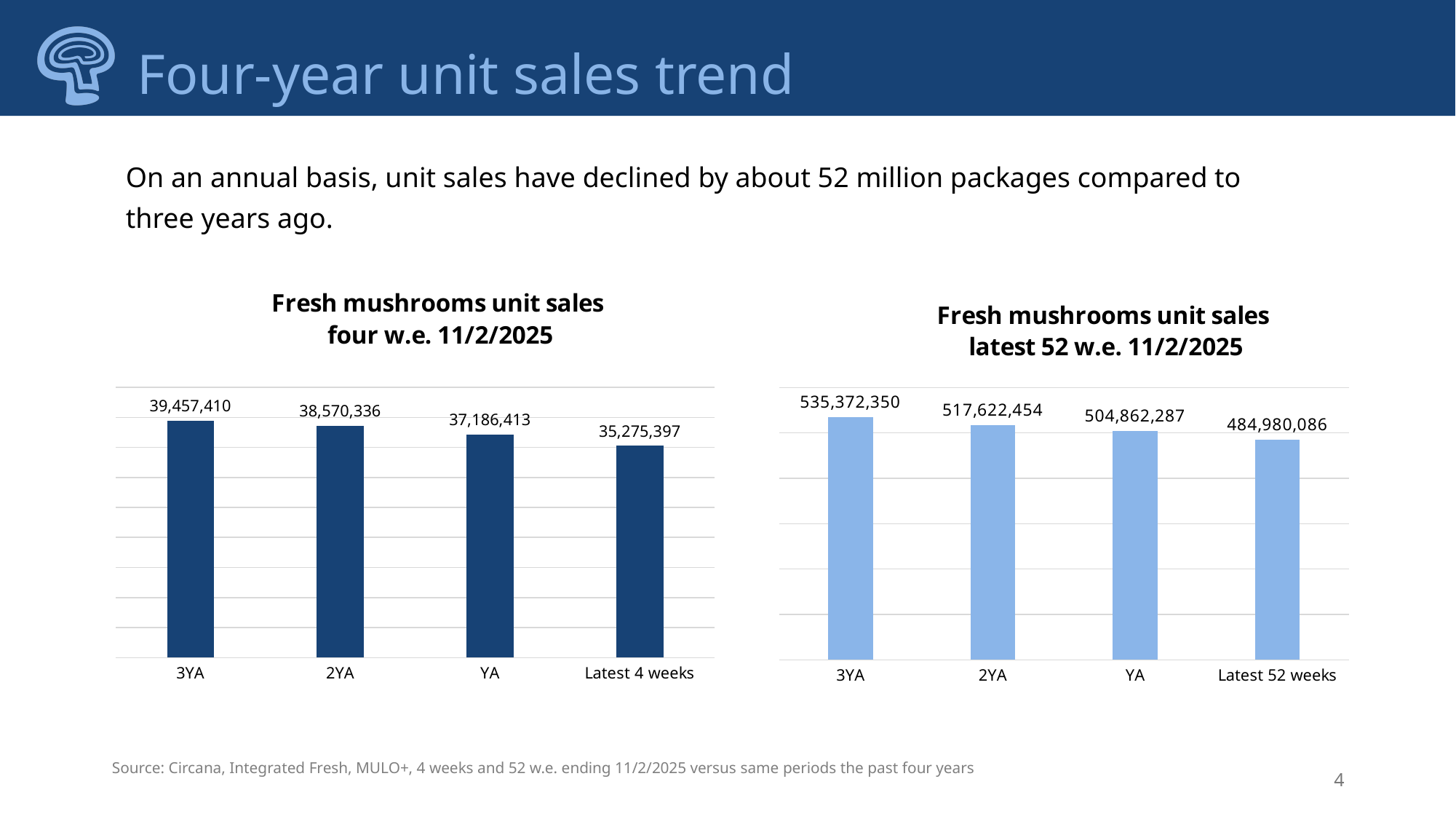
In the 'Fresh mushrooms unit sales four w.e. 11/2/2025' chart, which category has the highest value? 3YA In the 'Fresh mushrooms unit sales latest 52 w.e. 11/2/2025' chart, which category has the lowest value? Latest 52 weeks What kind of chart is the 'Fresh mushrooms unit sales latest 52 w.e. 11/2/2025' chart? Bar chart In the 'Fresh mushrooms unit sales latest 52 w.e. 11/2/2025' chart, what is the difference between the 3YA value and the Latest 52 weeks value? 50,392,264 In the 'Fresh mushrooms unit sales four w.e. 11/2/2025' chart, what is the value for Latest 4 weeks? 35,275,397 In the 'Fresh mushrooms unit sales latest 52 w.e. 11/2/2025' chart, what is the value for Latest 52 weeks? 484,980,086 In the 'Fresh mushrooms unit sales four w.e. 11/2/2025' chart, do the values rise or fall from 3YA to Latest 4 weeks? Fall In the 'Fresh mushrooms unit sales four w.e. 11/2/2025' chart, what is the value for 3YA? 39,457,410 How many categories are shown in the 'Fresh mushrooms unit sales four w.e. 11/2/2025' chart? 4 In the 'Fresh mushrooms unit sales four w.e. 11/2/2025' chart, what is the difference between the 3YA value and the Latest 4 weeks value? 4,182,013 In the 'Fresh mushrooms unit sales latest 52 w.e. 11/2/2025' chart, what is the value for 2YA? 517,622,454 In the 'Fresh mushrooms unit sales latest 52 w.e. 11/2/2025' chart, which is larger, the value for 2YA or the value for YA? 2YA